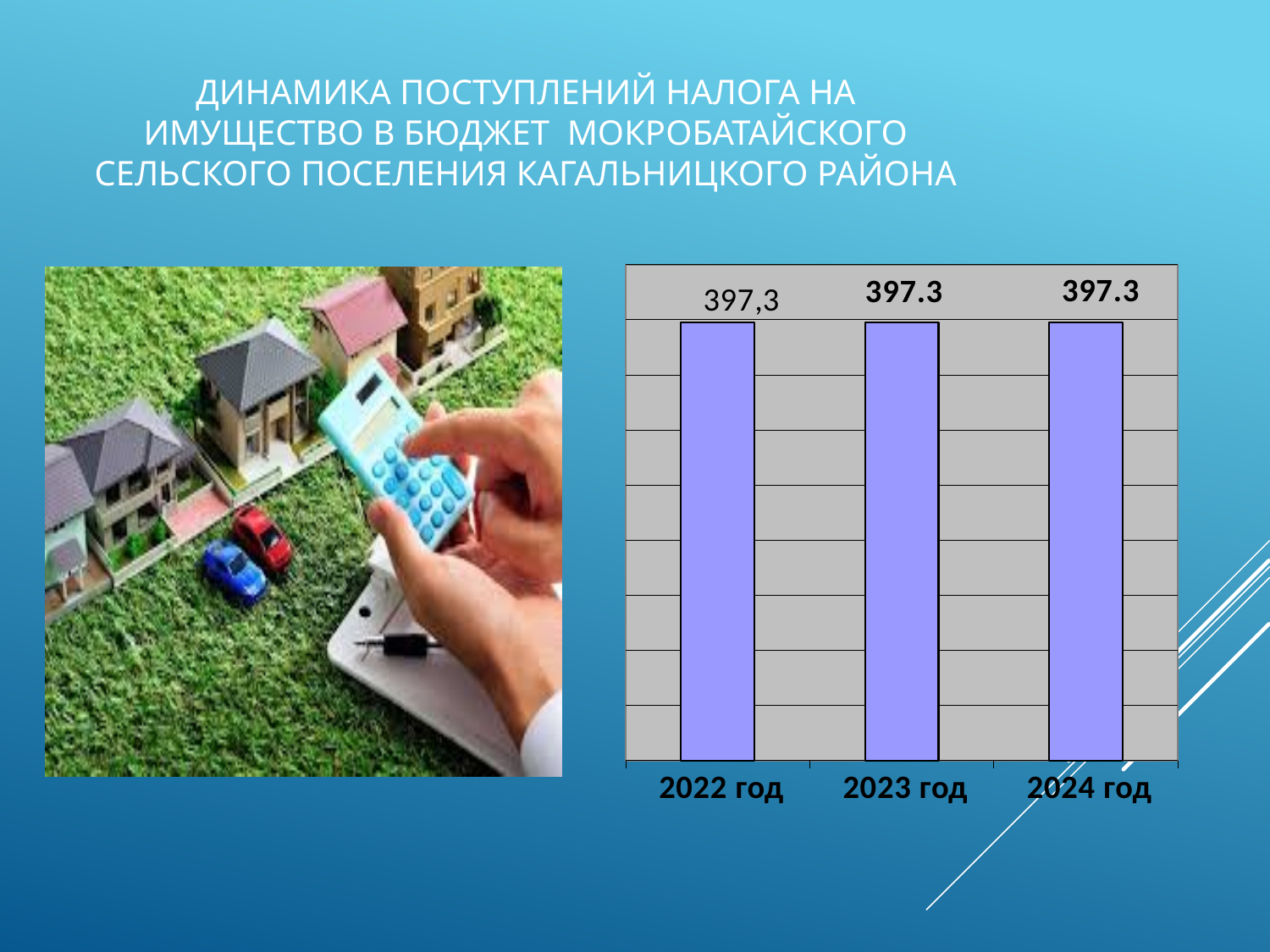
Which year is the first (leftmost) category on the x axis? 2022 год Is the value for 2024 год larger than, smaller than, or equal to the value for 2023 год? equal What colour are the bars in the chart? light purple Do the values rise, fall, or stay the same from 2022 год to 2024 год? stay the same What is the value shown for 2022 год? 397,3 What kind of chart is shown on the slide? bar chart What is the value shown for 2023 год? 397.3 What is the value shown for 2024 год? 397.3 What is the difference between the values for 2023 год and 2022 год? 0 How many bars (years) are plotted on the chart? 3